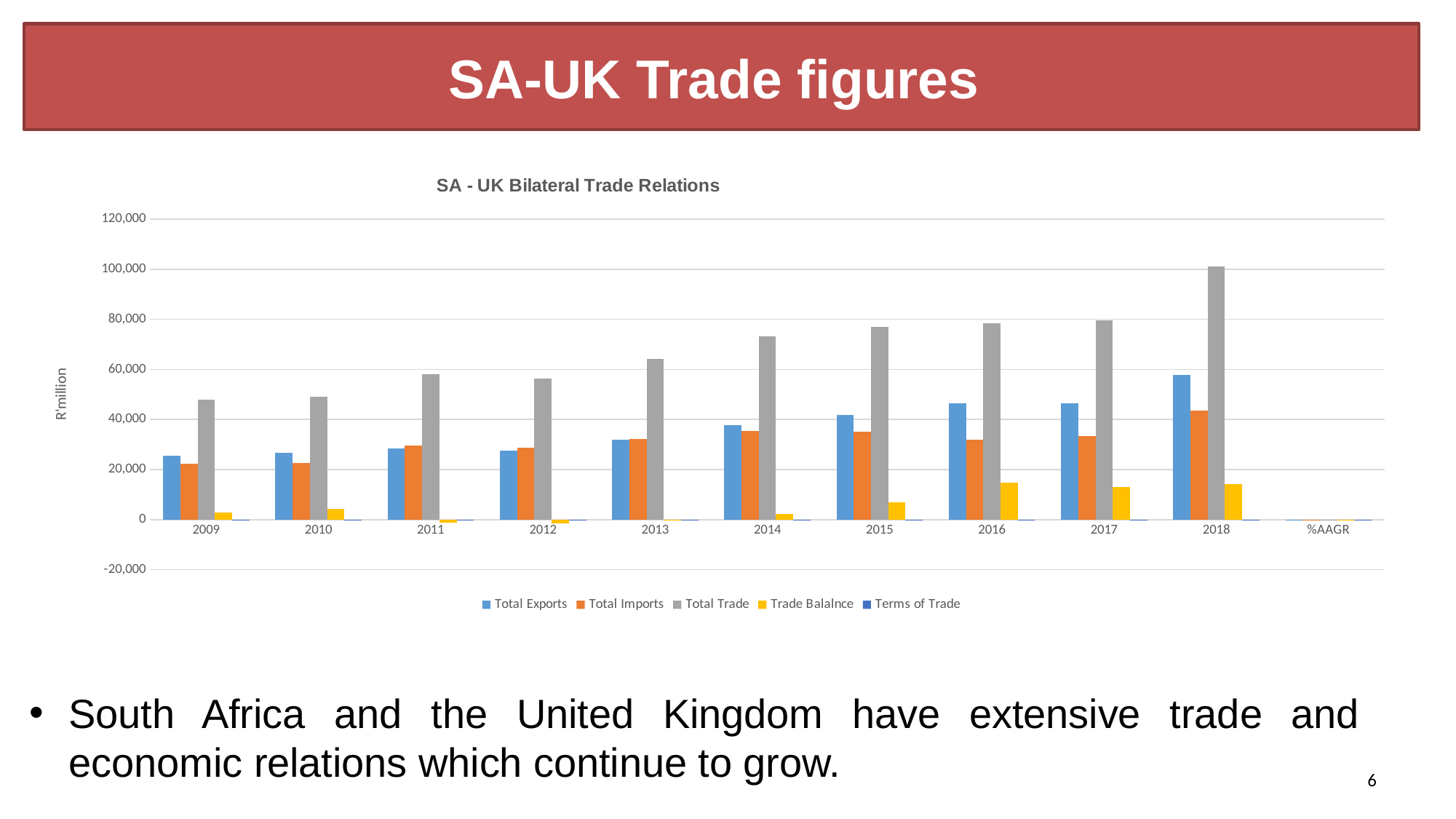
Does Total Trade generally rise or fall from 2009 to 2018? rise Is the Total Trade value for 2018 greater or less than 80,000? greater Is the Total Exports value for 2018 greater or less than 40,000? greater What is the title of the chart? SA - UK Bilateral Trade Relations In 2018, which is larger: Total Exports or Total Imports? Total Exports What is the label on the vertical axis of the chart? R'million How many series does the chart legend list? 5 Is the Total Trade value for 2012 greater or less than 60,000? less In which year is Total Trade highest? 2018 What type of chart is shown on the slide? bar chart How many categories are shown along the x axis of the chart? 11 In which year is Total Exports highest? 2018